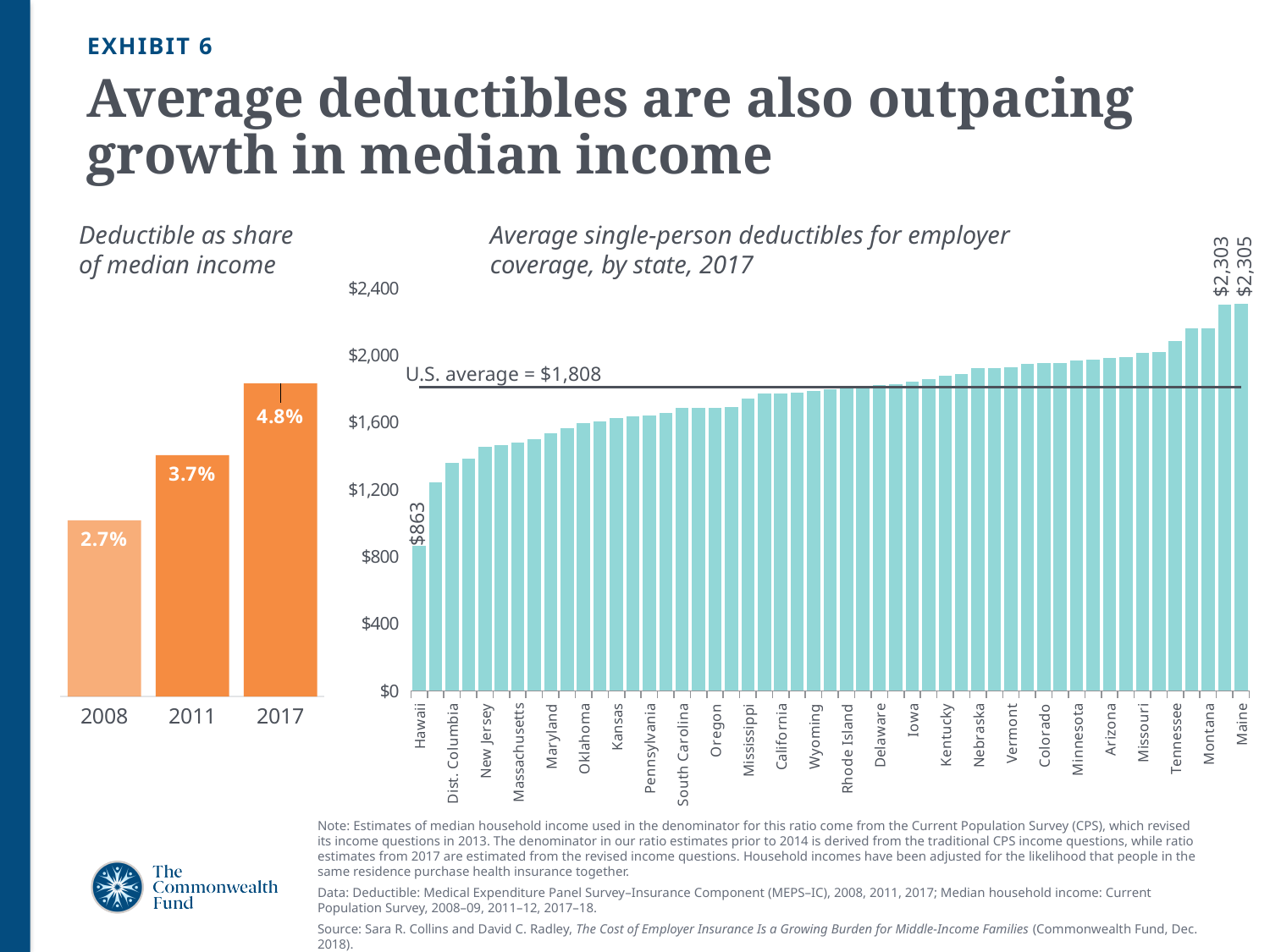
In the left chart (Deductible as share of median income), what is the value for 2017? 4.8% In the left chart (Deductible as share of median income), which year has the lowest value? 2008 In the right chart (Average single-person deductibles by state, 2017), what is the value for Maine? $2,305 In the left chart (Deductible as share of median income), by how many percentage points did the share rise from 2008 to 2017? 2.1 percentage points In the right chart (Average single-person deductibles by state, 2017), what is the value for Hawaii? $863 In the left chart (Deductible as share of median income), do the values rise or fall from 2008 to 2017? rise In the right chart (Average single-person deductibles by state, 2017), what is the U.S. average shown by the horizontal line? $1,808 In the left chart (Deductible as share of median income), what is the value for 2008? 2.7% In the right chart (Average single-person deductibles by state, 2017), what kind of chart is used? bar chart In the left chart (Deductible as share of median income), how many years are shown? 3 In the right chart (Average single-person deductibles by state, 2017), is the value for Maryland greater or less than $1,600? less In the right chart (Average single-person deductibles by state, 2017), which state has the lowest deductible? Hawaii